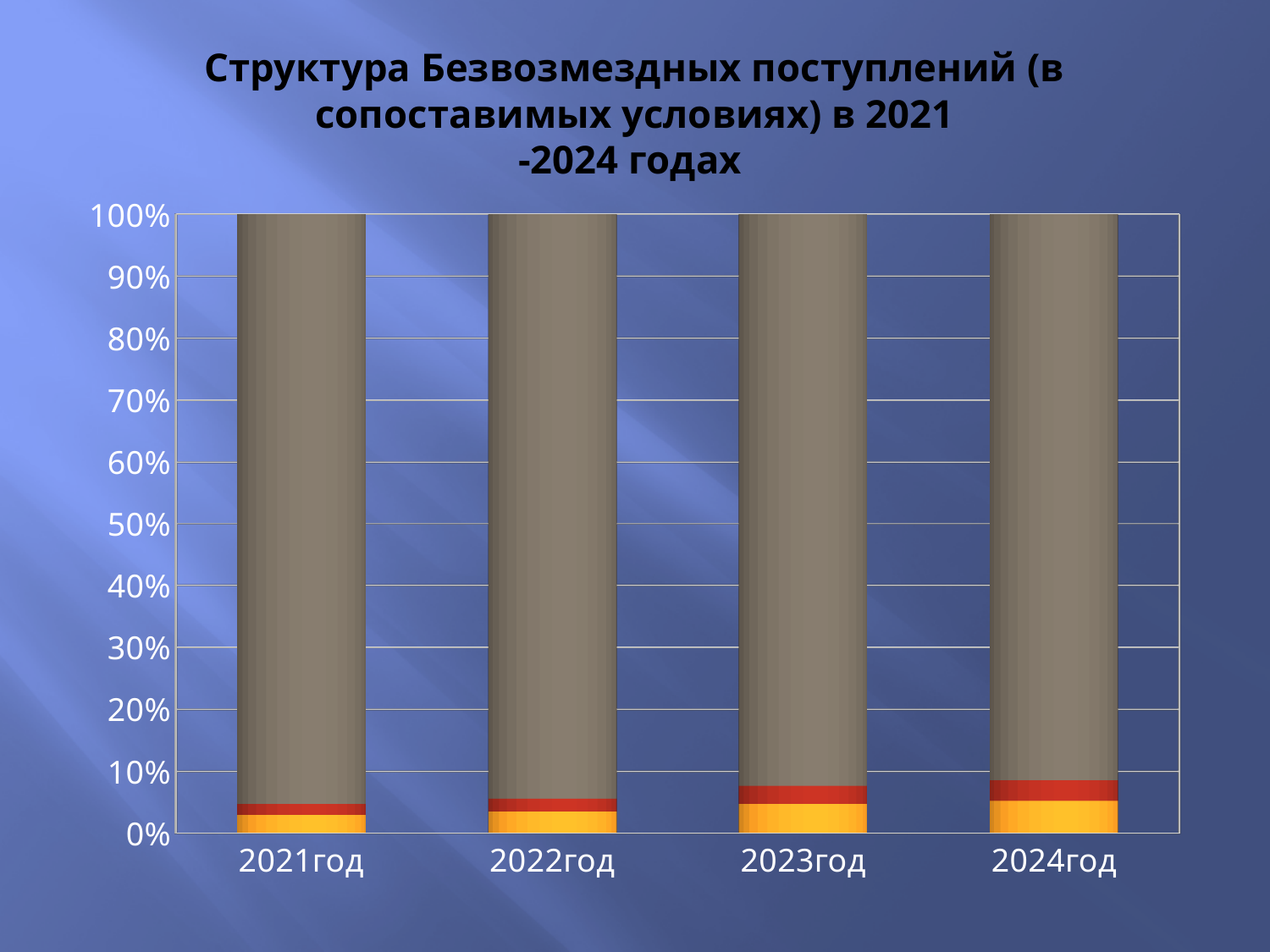
Which is larger: the grey (top) segment for 2021год or for 2024год? 2021год How many years (categories) are shown on the x axis of the chart? 4 What is the title of the chart? Структура Безвозмездных поступлений (в сопоставимых условиях) в 2021-2024 годах Is the grey (top) segment of the bar for 2024год greater or less than 80%? greater Is the combined height of the red and yellow (bottom) segments for 2024год greater or less than 10%? less Is the combined height of the red and yellow (bottom) segments for 2022год greater or less than 10%? less Which year has the largest combined red and yellow (bottom) segment? 2024год What kind of chart is shown on the slide? Stacked bar chart Do the combined red and yellow (bottom) segments rise or fall from 2021год to 2024год? rise Which is larger: the combined red and yellow (bottom) segment for 2021год or for 2024год? 2024год What is the label of the first category on the x axis? 2021год